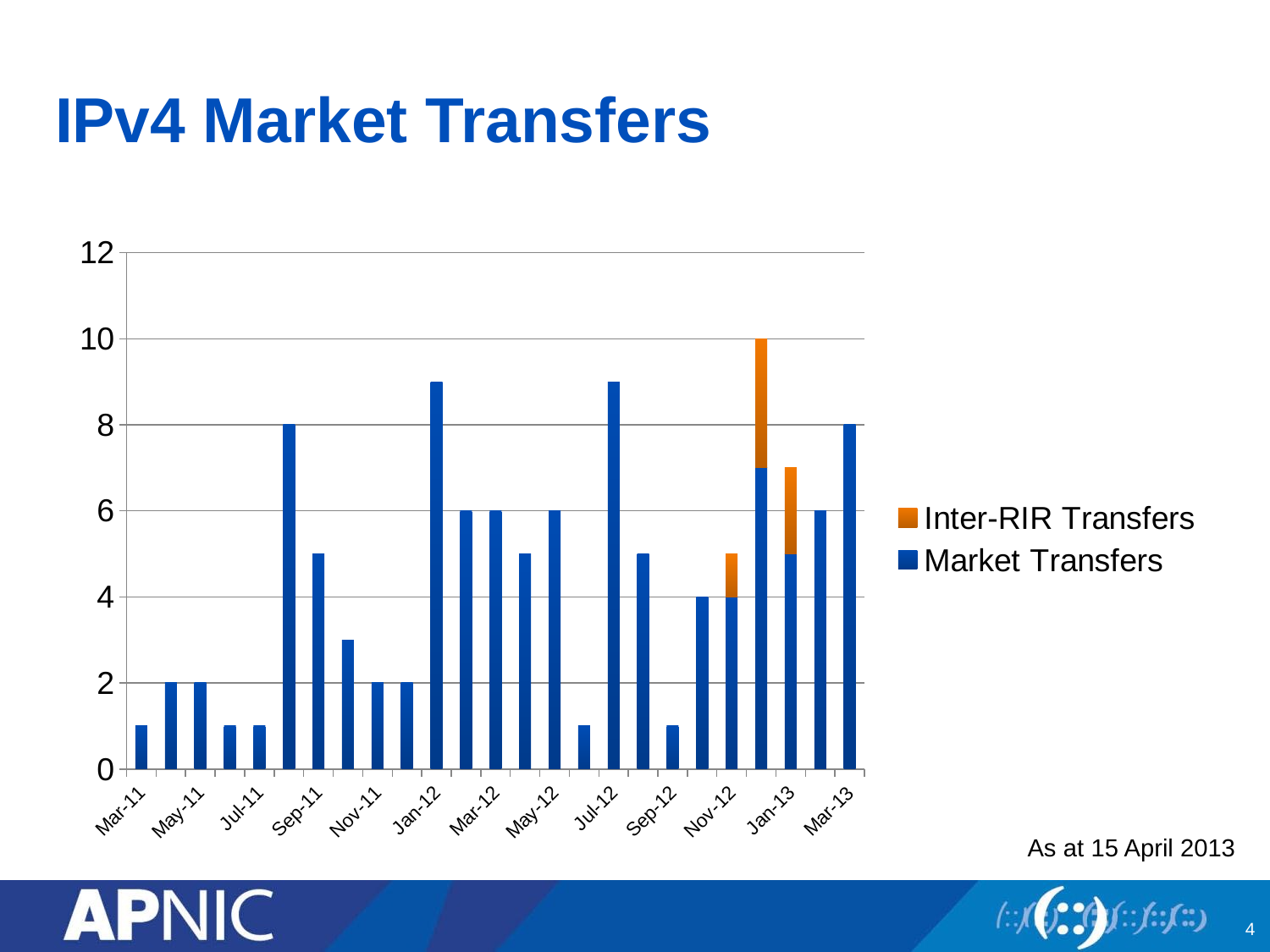
What is the title of the chart? IPv4 Market Transfers Which is larger, the Market Transfers value for Jan-12 or for Mar-12? Jan-12 What kind of chart is shown on the slide? bar chart Is the Market Transfers value for Sep-11 greater or less than 6? less How many series does the legend list? 2 What is the value of Market Transfers for Mar-12? 6 Which colour represents Inter-RIR Transfers in the legend? orange What is the value of Market Transfers for Mar-13? 8